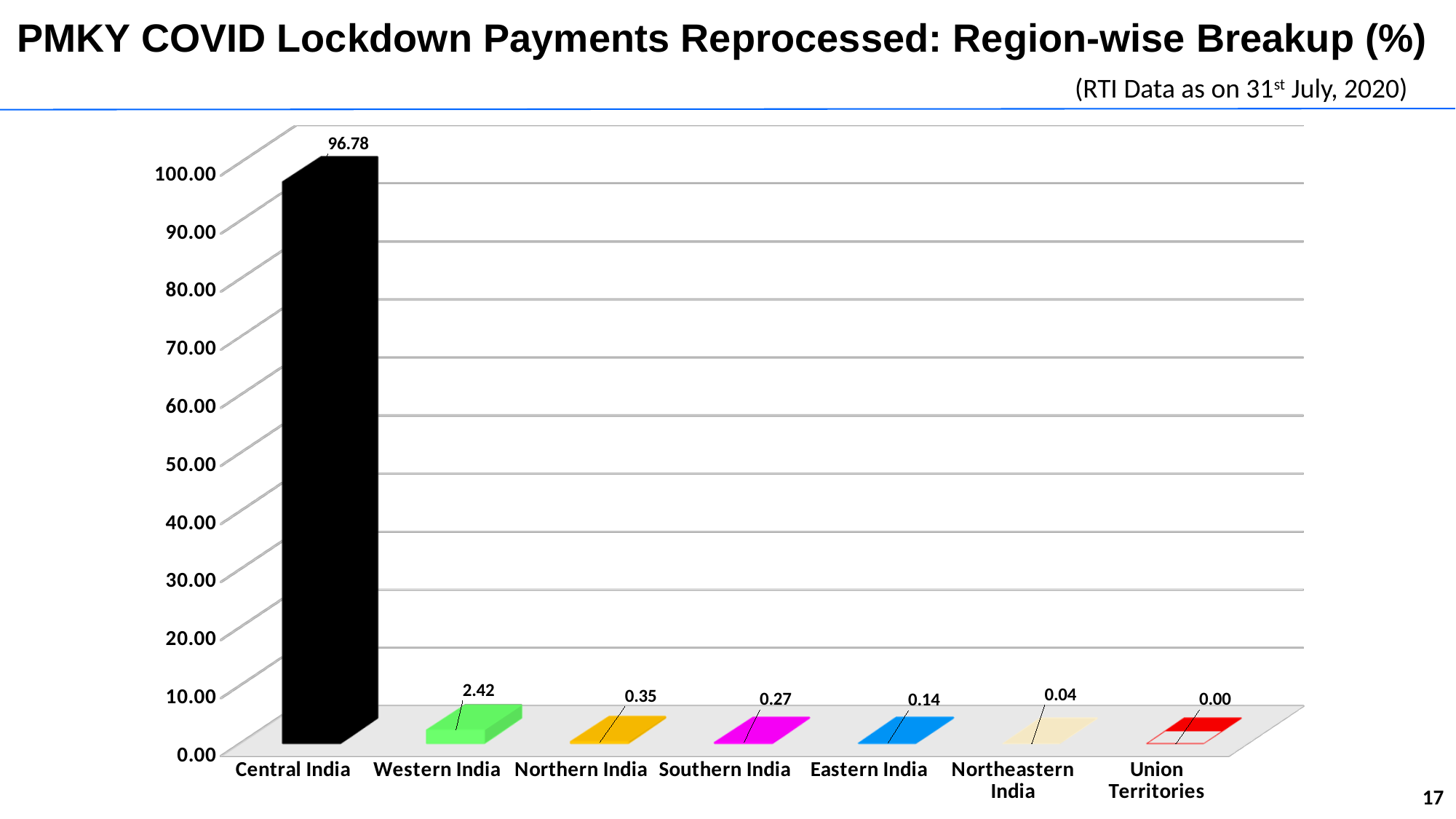
What is the value for Union Territories? 0.00 Is the value for Central India greater or less than 90.00? greater Which region has the lowest value? Union Territories Which is larger, the value for Southern India or the value for Northeastern India? Southern India What is the value for Northern India? 0.35 What is the difference between the values for Central India and Western India? 94.36 What is the value for Eastern India? 0.14 What is the value for Central India? 96.78 What is the value for Western India? 2.42 How many regions are shown on the x axis? 7 Which region has the highest value? Central India What kind of chart is shown on the slide? bar chart